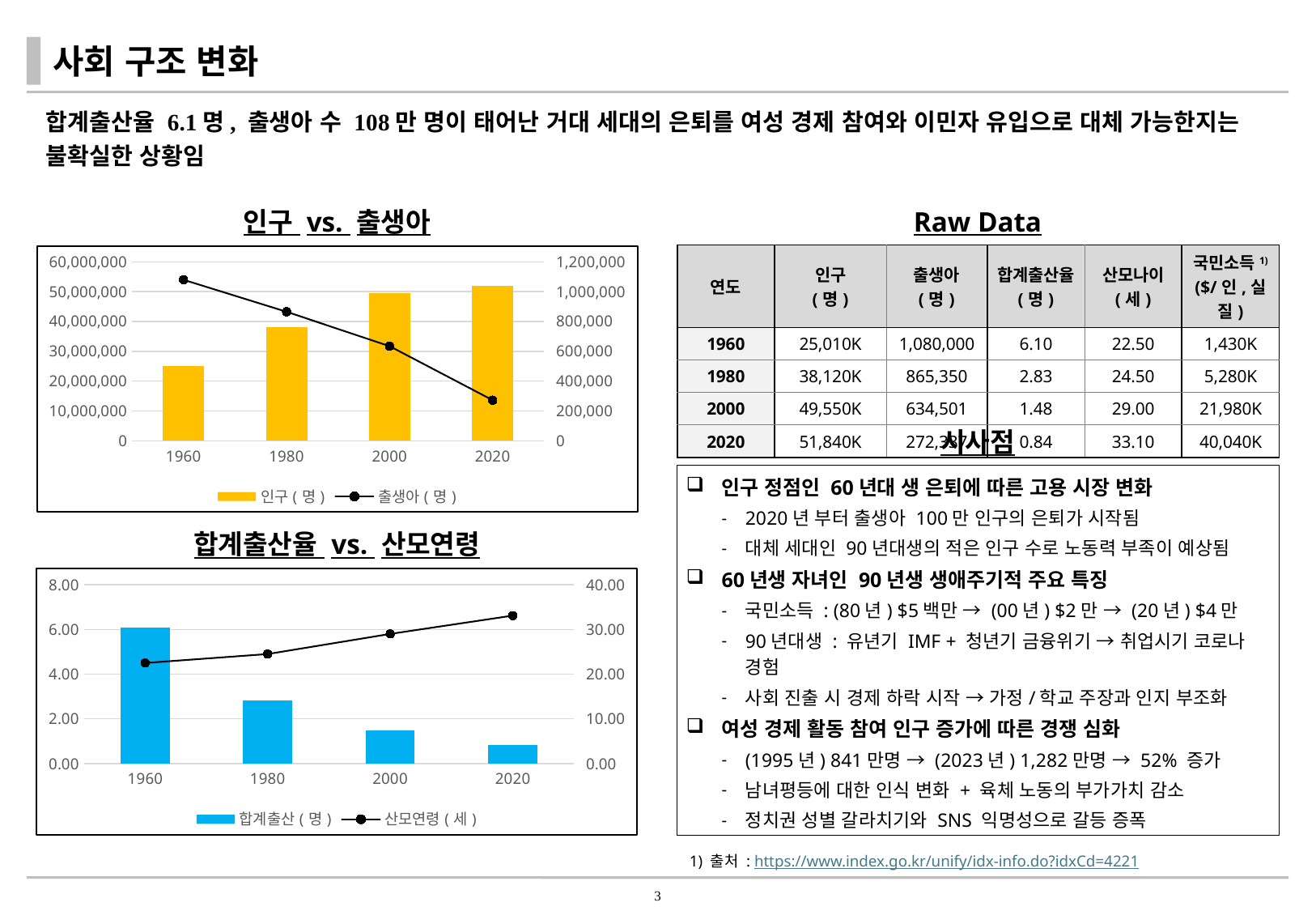
In the '합계출산율 vs. 산모연령' chart, which year has the lowest 합계출산 (명) bar? 2020 In the '합계출산율 vs. 산모연령' chart, what colour are the 합계출산 (명) bars? Blue How many series does the legend of the '인구 vs. 출생아' chart list? 2 How many years are shown on the x axis of the '인구 vs. 출생아' chart? 4 In the '인구 vs. 출생아' chart, does the 출생아 (명) line rise or fall from 1960 to 2020? fall In the '인구 vs. 출생아' chart, is the 출생아 (명) value for 1960 greater or less than 1,000,000? greater What kind of chart is the '인구 vs. 출생아' chart? A bar chart combined with a line In the '합계출산율 vs. 산모연령' chart, which year has the highest 합계출산 (명) bar? 1960 In the '합계출산율 vs. 산모연령' chart, is the 산모연령 (세) value for 2020 greater or less than 30.00? greater In the '합계출산율 vs. 산모연령' chart, does the 산모연령 (세) line rise or fall from 1960 to 2020? rise In the '인구 vs. 출생아' chart, which year has the lowest 인구 (명) bar? 1960 In the '인구 vs. 출생아' chart, is the 인구 (명) value for 1960 greater or less than 30,000,000? less